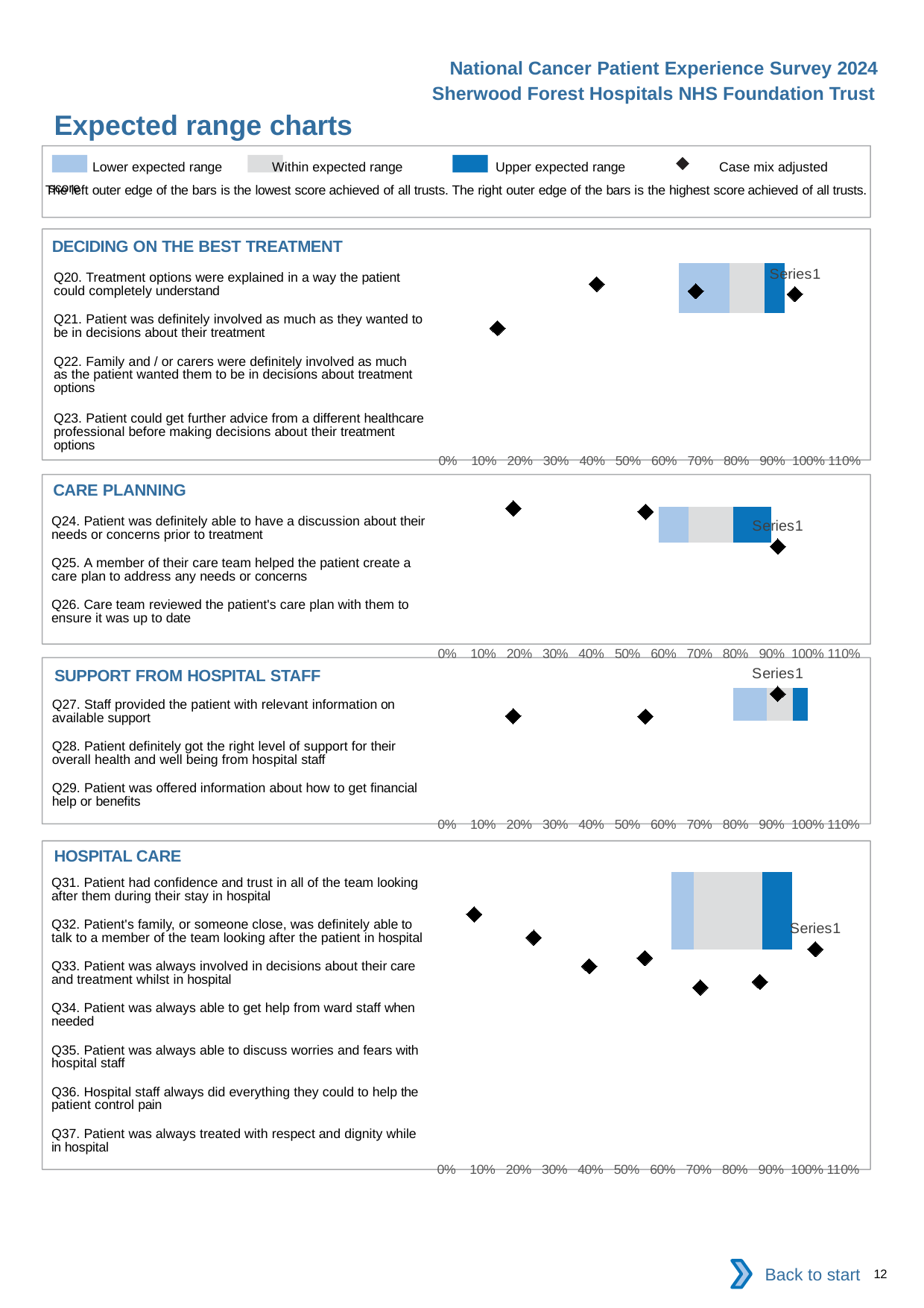
In the Hospital Care chart, is the leftmost diamond marker greater or less than 20%? less How many diamond markers are plotted in the Deciding on the Best Treatment chart? 4 What kind of chart is used in the Deciding on the Best Treatment section? bar chart In the Care Planning chart, is the rightmost diamond marker greater or less than 80%? greater In the Deciding on the Best Treatment chart, is the rightmost diamond marker greater or less than 90%? greater How many diamond markers are plotted in the Care Planning chart? 3 How many questions are listed in the Hospital Care section? 7 How many entries does the legend at the top of the slide list? 4 In the legend, what does the dark blue colour represent? Upper expected range What is the highest tick label shown on the x axis of the charts? 110%